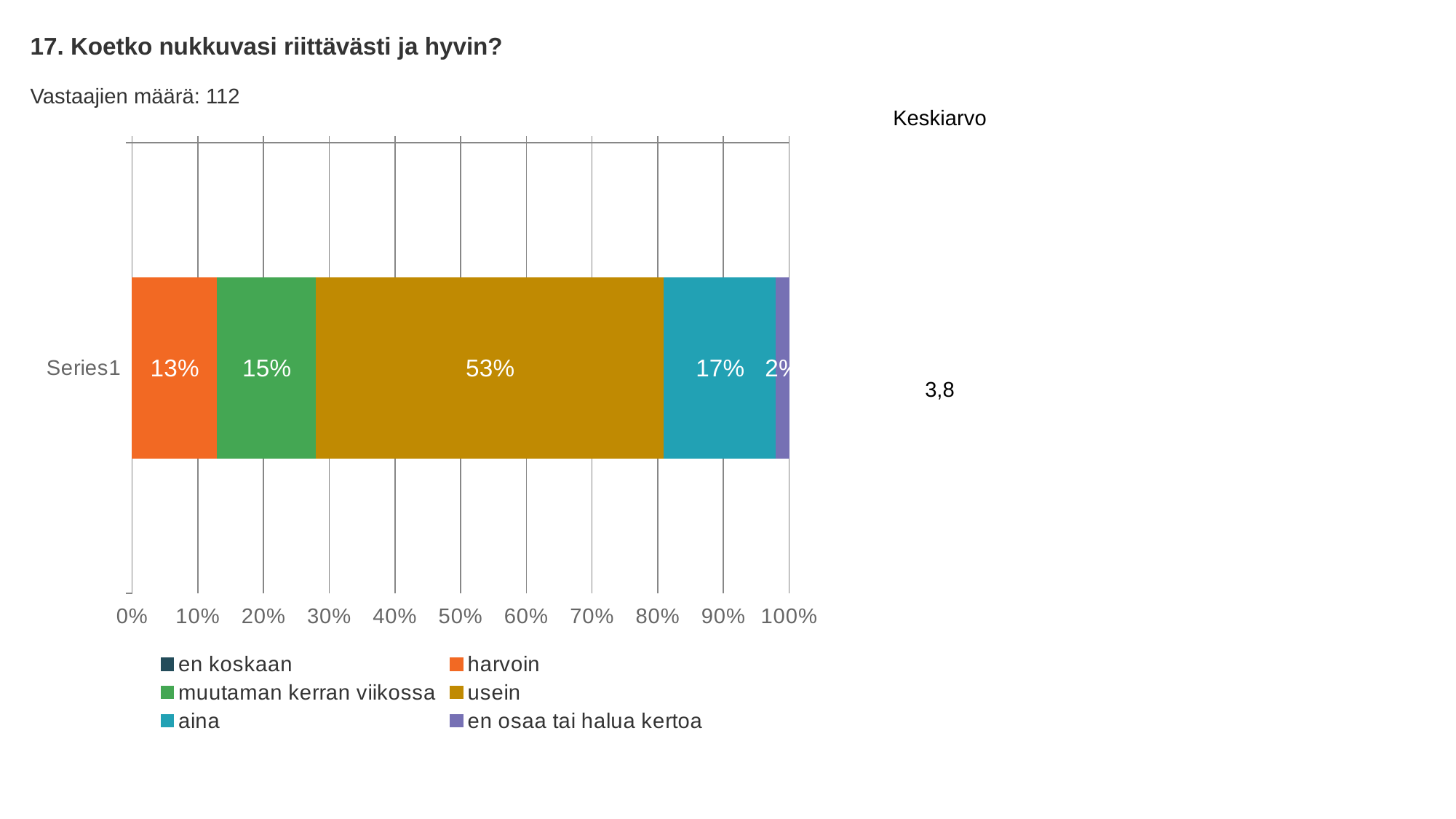
What percentage of respondents answered "aina"? 17% What kind of chart is shown on the slide? stacked bar chart What percentage of respondents answered "usein"? 53% Which is larger, the share for "aina" or the share for "harvoin"? aina Which response option has the largest share of the bar? usein What percentage of respondents answered "harvoin"? 13% What is the Keskiarvo (average) value shown on the slide? 3,8 How many respondents (Vastaajien määrä) are reported on the slide? 112 How many entries does the legend list? 6 Which visible segment of the bar has the smallest share? en osaa tai halua kertoa What is the difference in percentage points between "usein" and "aina"? 36 What percentage of respondents answered "muutaman kerran viikossa"? 15%